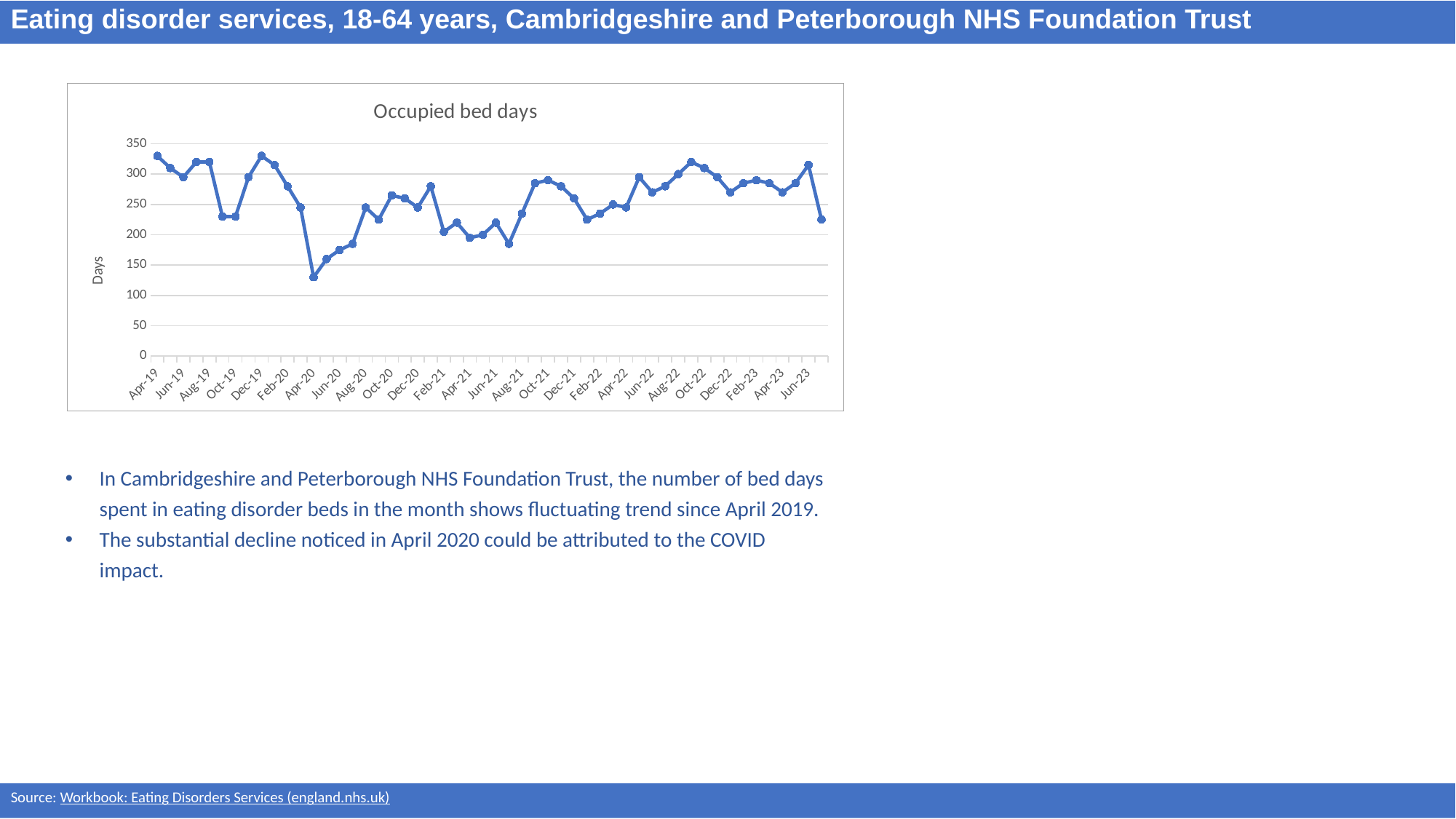
What is the label on the vertical axis of the chart? Days Is the value for Apr-20 greater or less than 150? less Is the value for Jun-23 greater or less than 300? greater Do the values rise or fall between Feb-20 and Apr-20? fall Which is larger, the value for Oct-19 or the value for Dec-19? Dec-19 Is the value for Apr-19 greater or less than 300? greater What is the title of the chart? Occupied bed days Which month has the lowest number of occupied bed days? Apr-20 What kind of chart is shown on the slide? line chart Which is larger, the value for Apr-19 or the value for Apr-20? Apr-19